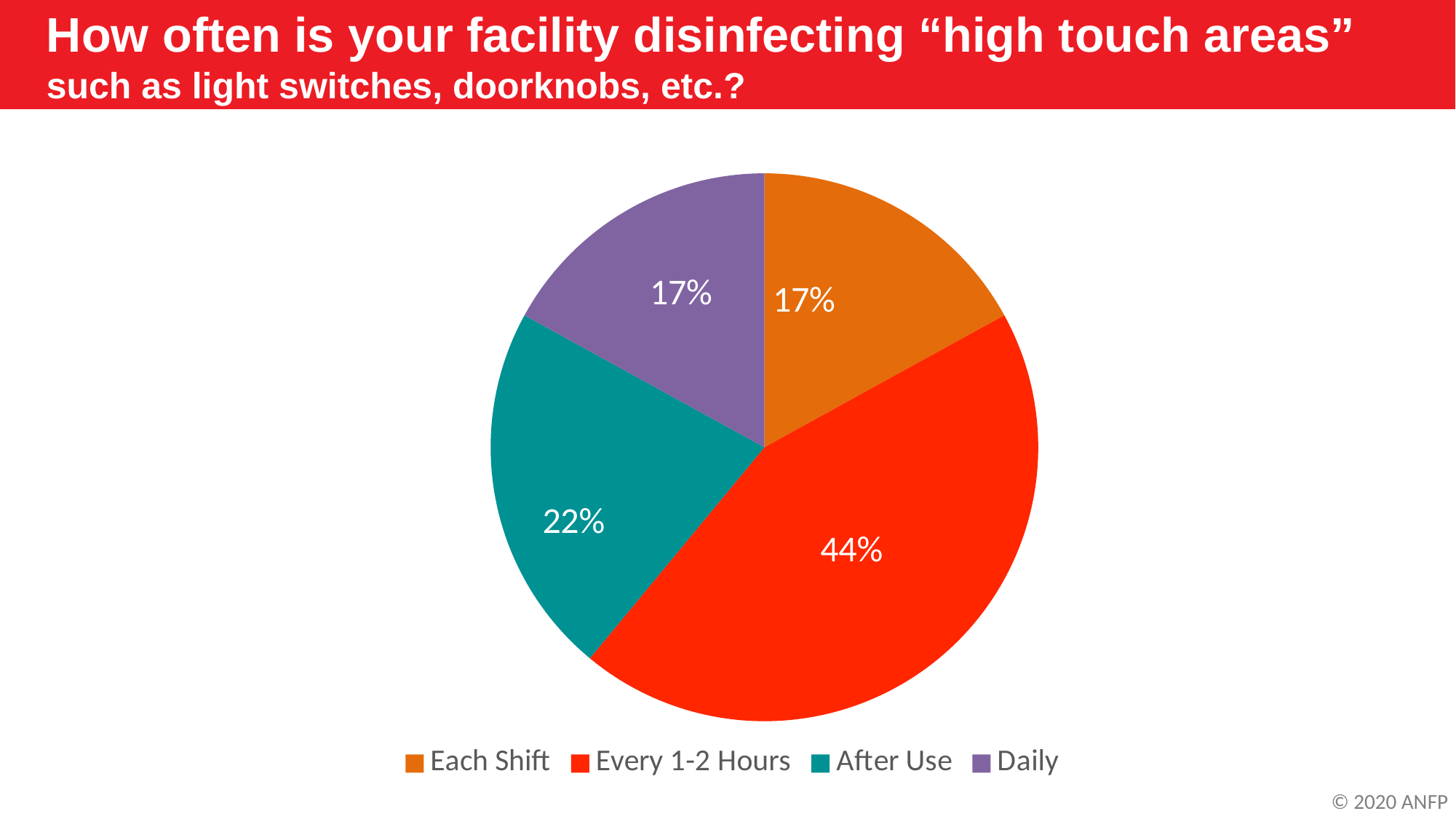
What percentage of facilities disinfect high touch areas Every 1-2 Hours? 44% Which is larger, the share for After Use or the share for Daily? After Use How many categories does the pie chart show? 4 What percentage of facilities disinfect high touch areas After Use? 22% What is the difference in percentage points between Every 1-2 Hours and After Use? 22 What is the difference in percentage points between Every 1-2 Hours and Each Shift? 27 What percentage of facilities disinfect high touch areas Each Shift? 17% How many entries does the legend list? 4 What percentage of facilities disinfect high touch areas Daily? 17% Which category has the largest share of the pie? Every 1-2 Hours What type of chart is shown on the slide? pie chart What colour is the slice for Every 1-2 Hours? red